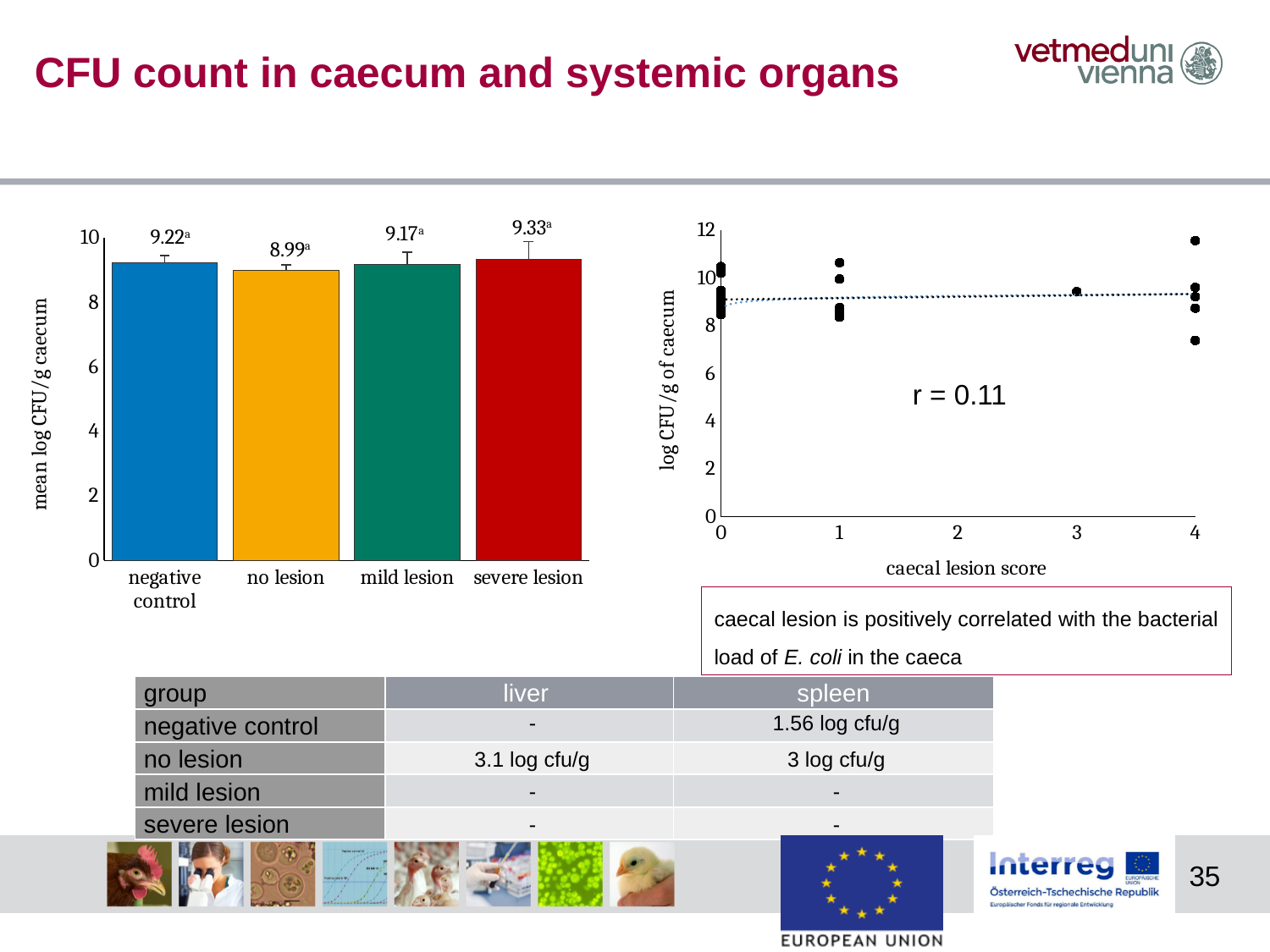
In the scatter plot on the right, what correlation coefficient r is printed on the chart? r = 0.11 In the bar chart on the left, what is the mean log CFU/g caecum for the severe lesion group? 9.33 What kind of chart is the chart on the left of the slide? bar chart In the bar chart on the left, which group has the lowest mean log CFU/g caecum? no lesion In the bar chart on the left, which is larger: the value for negative control or the value for mild lesion? negative control In the bar chart on the left, what is the mean log CFU/g caecum for the negative control group? 9.22 In the bar chart on the left, what is the mean log CFU/g caecum for the mild lesion group? 9.17 What kind of chart is the chart on the right of the slide? scatter plot In the bar chart on the left, how many groups are shown on the x axis? 4 In the bar chart on the left, what is the difference between the severe lesion value and the no lesion value? 0.34 In the bar chart on the left, what is the mean log CFU/g caecum for the no lesion group? 8.99 In the bar chart on the left, which group has the highest mean log CFU/g caecum? severe lesion